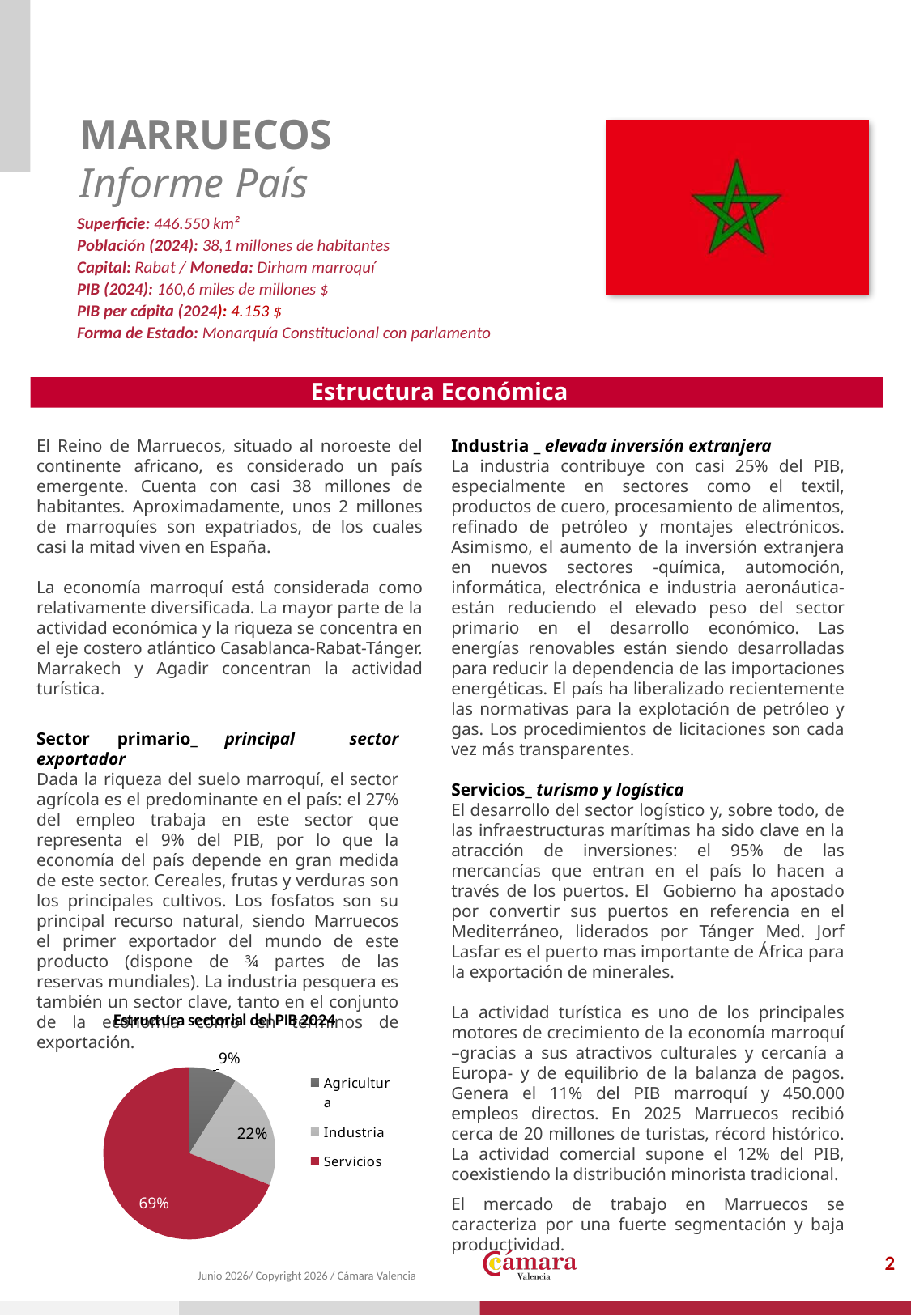
What kind of chart is shown on the slide? pie chart Which is larger, the share for Industria or the share for Agricultura? Industria What share of the pie does Agricultura represent? 9% What is the title of the chart on the slide? Estructura sectorial del PIB 2024 What share of the pie does Industria represent? 22% Which sector has the smallest slice of the pie? Agricultura How many slices does the pie chart have? 3 How many entries does the chart legend list? 3 What is the difference in percentage points between Servicios and Industria? 47 What share of the pie does Servicios represent? 69% Which sector has the largest slice of the pie? Servicios What is the difference in percentage points between Industria and Agricultura? 13